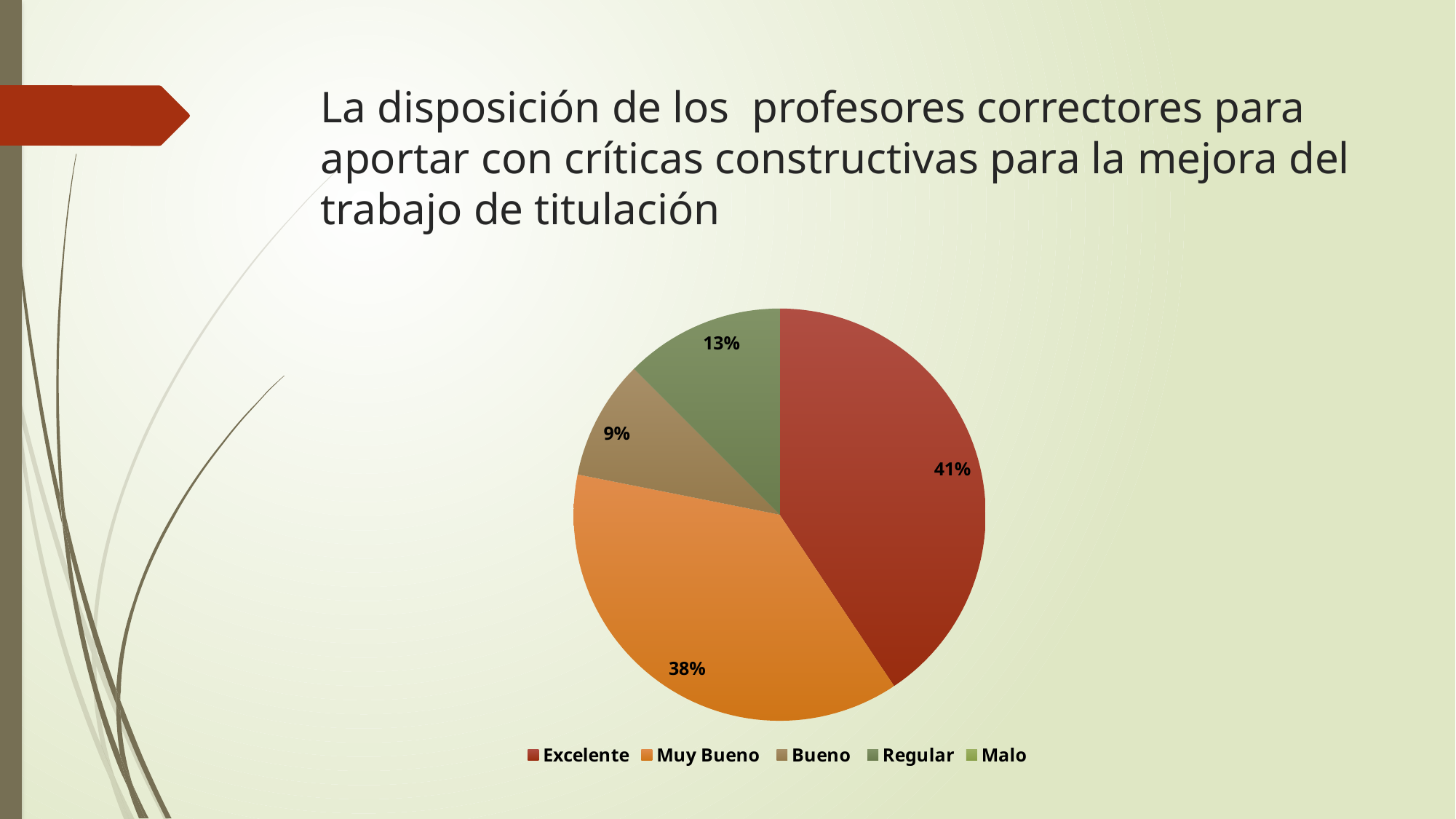
Which labelled slice has the smallest share of the pie? Bueno What is the difference in percentage points between the Excelente and Muy Bueno slices? 3 What colour is the Muy Bueno slice? orange What kind of chart is shown on the slide? pie chart Which category has the largest share of the pie? Excelente How many slices with percentage labels are visible in the pie? 4 What percentage of the pie is labelled for Regular? 13% Which slice is larger, Regular or Bueno? Regular What percentage of the pie is labelled for Muy Bueno? 38% How many entries does the legend list? 5 What percentage of the pie is labelled for Excelente? 41% What percentage of the pie is labelled for Bueno? 9%